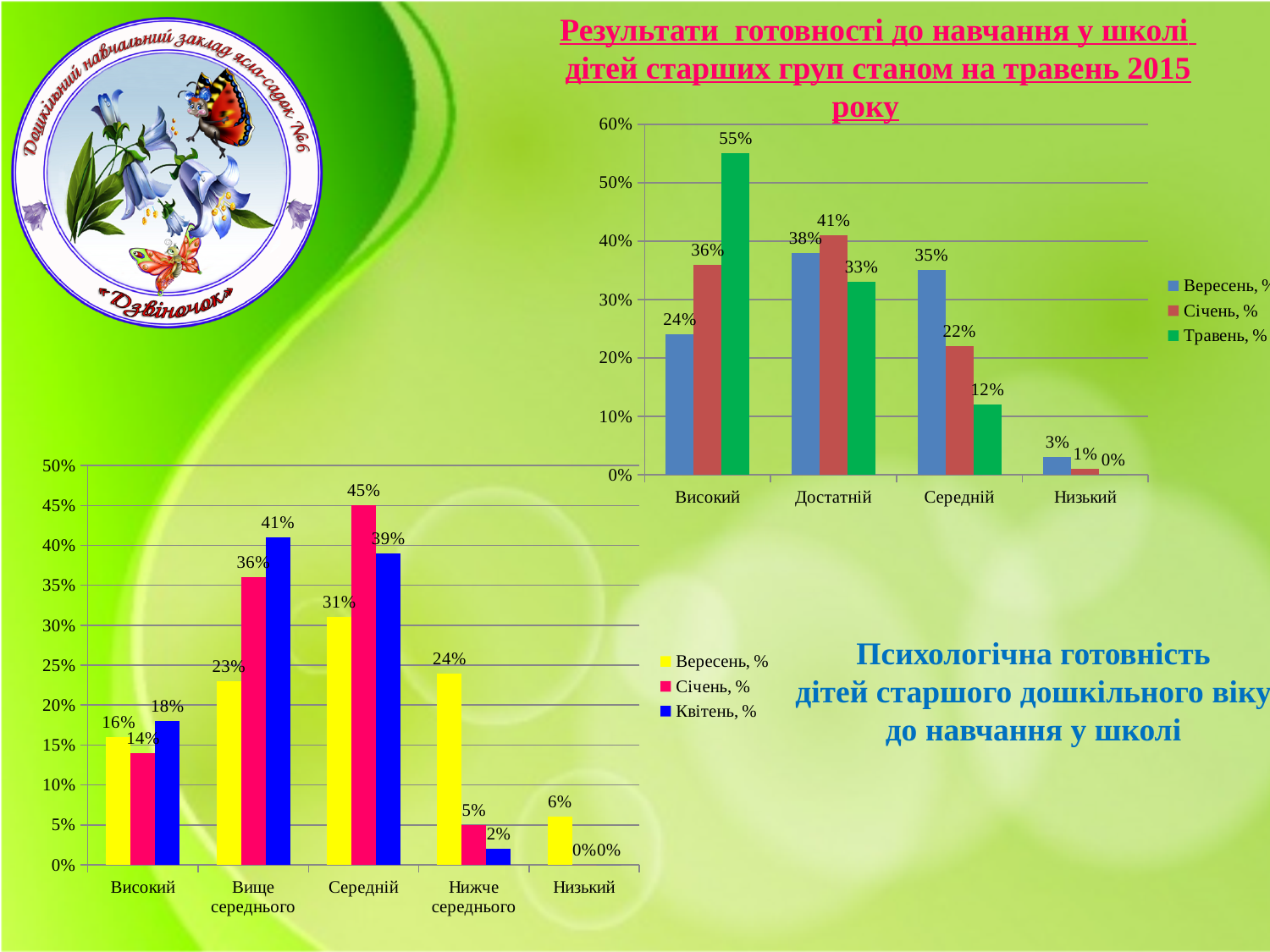
In the top-right chart, what is the value for Січень, % in the Достатній category? 41% In the top-right chart, how many series does the legend list? 3 In the bottom-left chart, what is the value for Січень, % in the Середній category? 45% What type of chart is the bottom-left chart? Bar chart In the bottom-left chart, how many categories are shown on the x axis? 5 In the top-right chart, which category has the highest value for Вересень, %? Достатній In the top-right chart, what is the difference between the Травень, % and Вересень, % values for Високий? 31% In the bottom-left chart, what is the value for Квітень, % in the Нижче середнього category? 2% In the bottom-left chart, which category has the lowest value for Вересень, %? Низький In the bottom-left chart, which is larger for Вище середнього: Січень, % or Квітень, %? Квітень, % In the top-right chart, how many categories are shown on the x axis? 4 In the top-right chart, what is the value for Травень, % in the Високий category? 55%